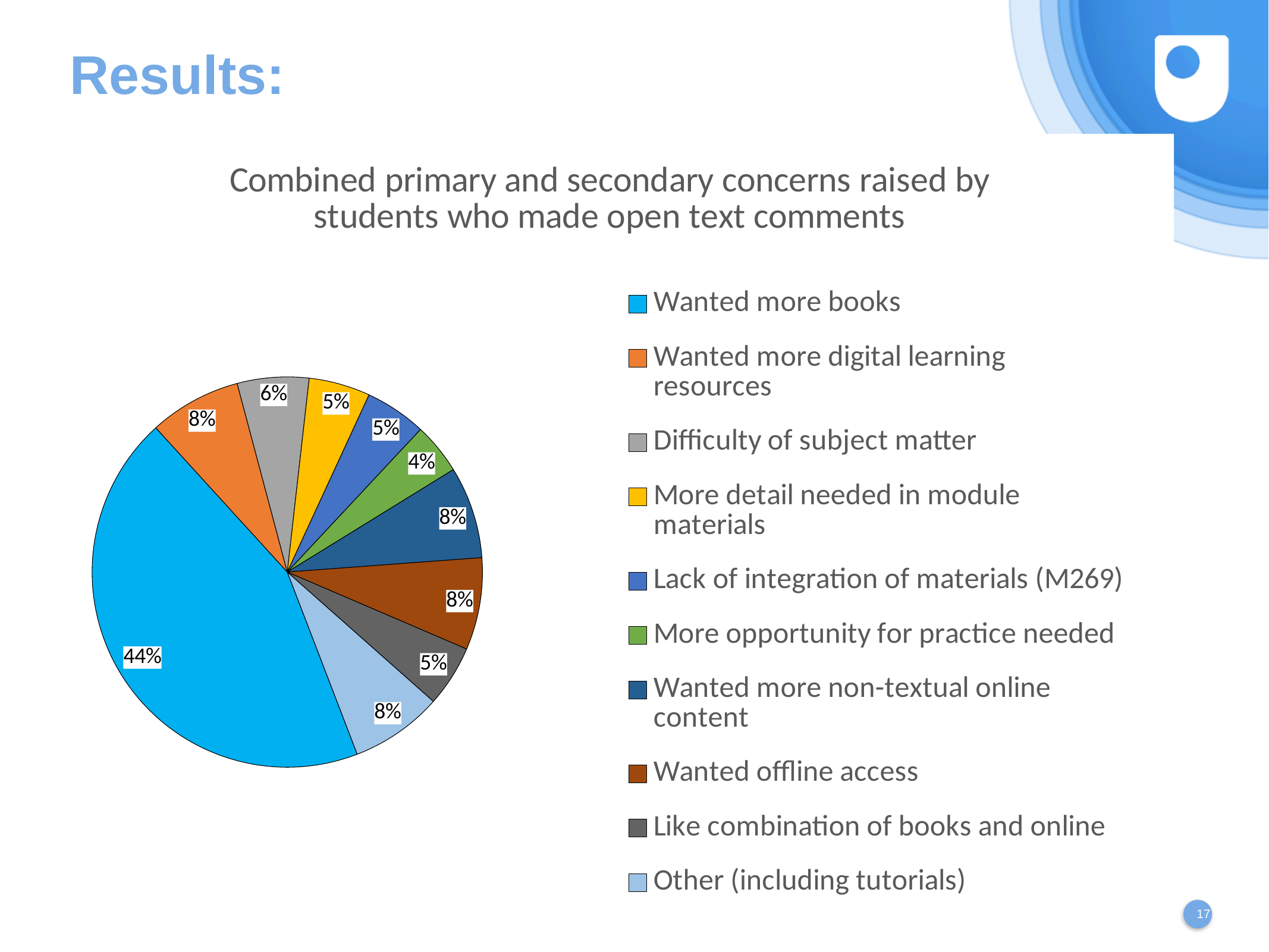
How many slices does the pie chart have? 10 What type of chart is shown on the slide? Pie chart Which category has the smallest slice of the pie? More opportunity for practice needed What share of the pie is labelled for "Wanted more books"? 44% What is the difference in percentage points between "Wanted more books" and "Wanted more digital learning resources"? 36 What percentage is shown for "More opportunity for practice needed"? 4% What is the title of the chart? Combined primary and secondary concerns raised by students who made open text comments What percentage is shown for "Lack of integration of materials (M269)"? 5% Which category has the largest slice of the pie? Wanted more books What percentage is shown for "Difficulty of subject matter"? 6% What percentage is shown for "Wanted offline access"? 8% Which is larger: the slice for "Difficulty of subject matter" or the slice for "More detail needed in module materials"? Difficulty of subject matter